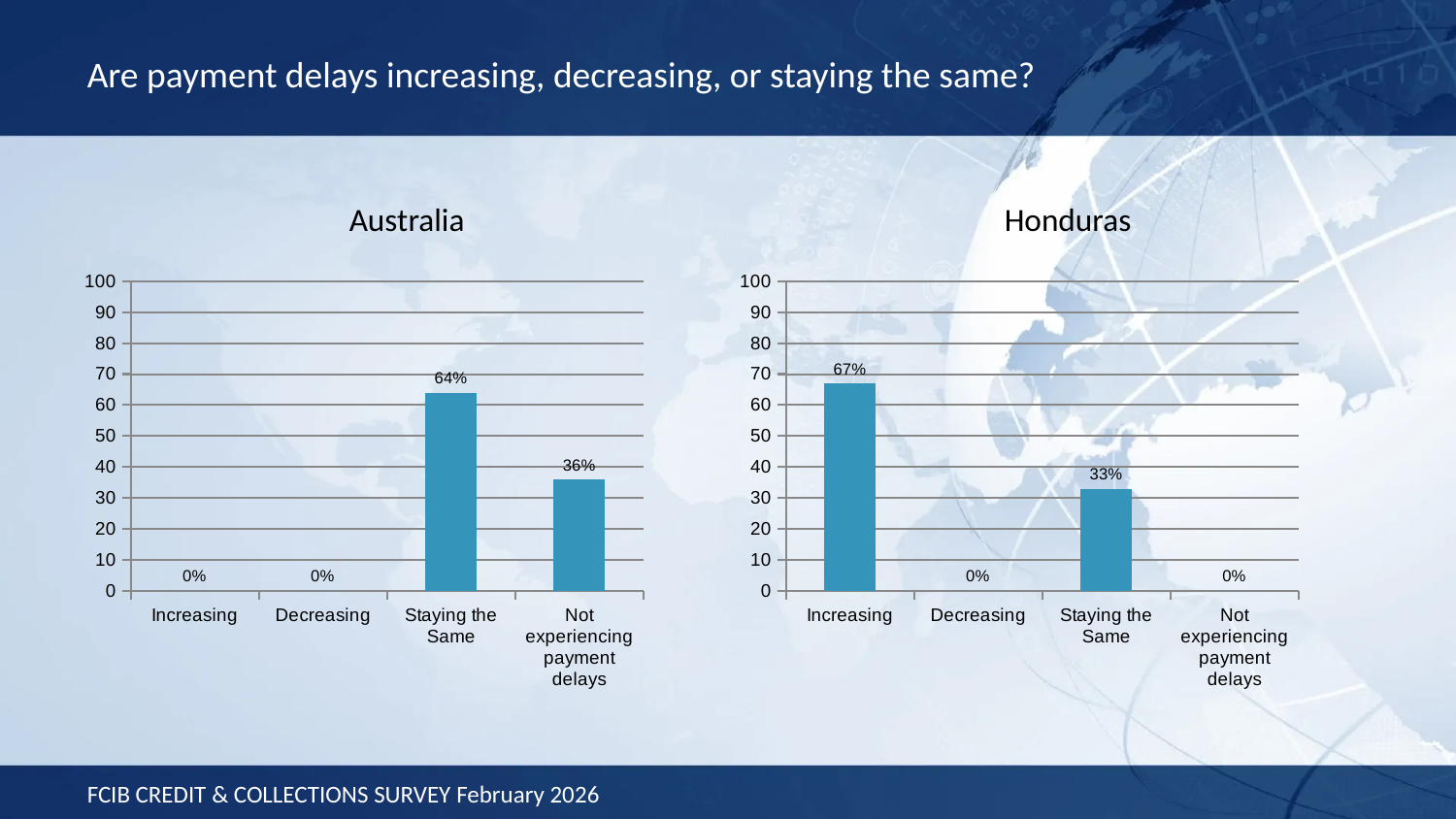
In the Australia chart, what is the value for Staying the Same? 64% In the Australia chart, what is the value for Decreasing? 0% What kind of chart is the Australia chart? Bar chart In the Honduras chart, what is the value for Increasing? 67% In the Australia chart, which category has the highest value? Staying the Same How many categories are shown on the x axis of the Honduras chart? 4 In the Australia chart, what is the value for Not experiencing payment delays? 36% In the Honduras chart, what is the value for Staying the Same? 33% In the Honduras chart, what is the difference between Increasing and Staying the Same? 34% In the Australia chart, what is the difference between Staying the Same and Not experiencing payment delays? 28% In the Honduras chart, which is larger, Increasing or Staying the Same? Increasing In the Honduras chart, which category has the highest value? Increasing